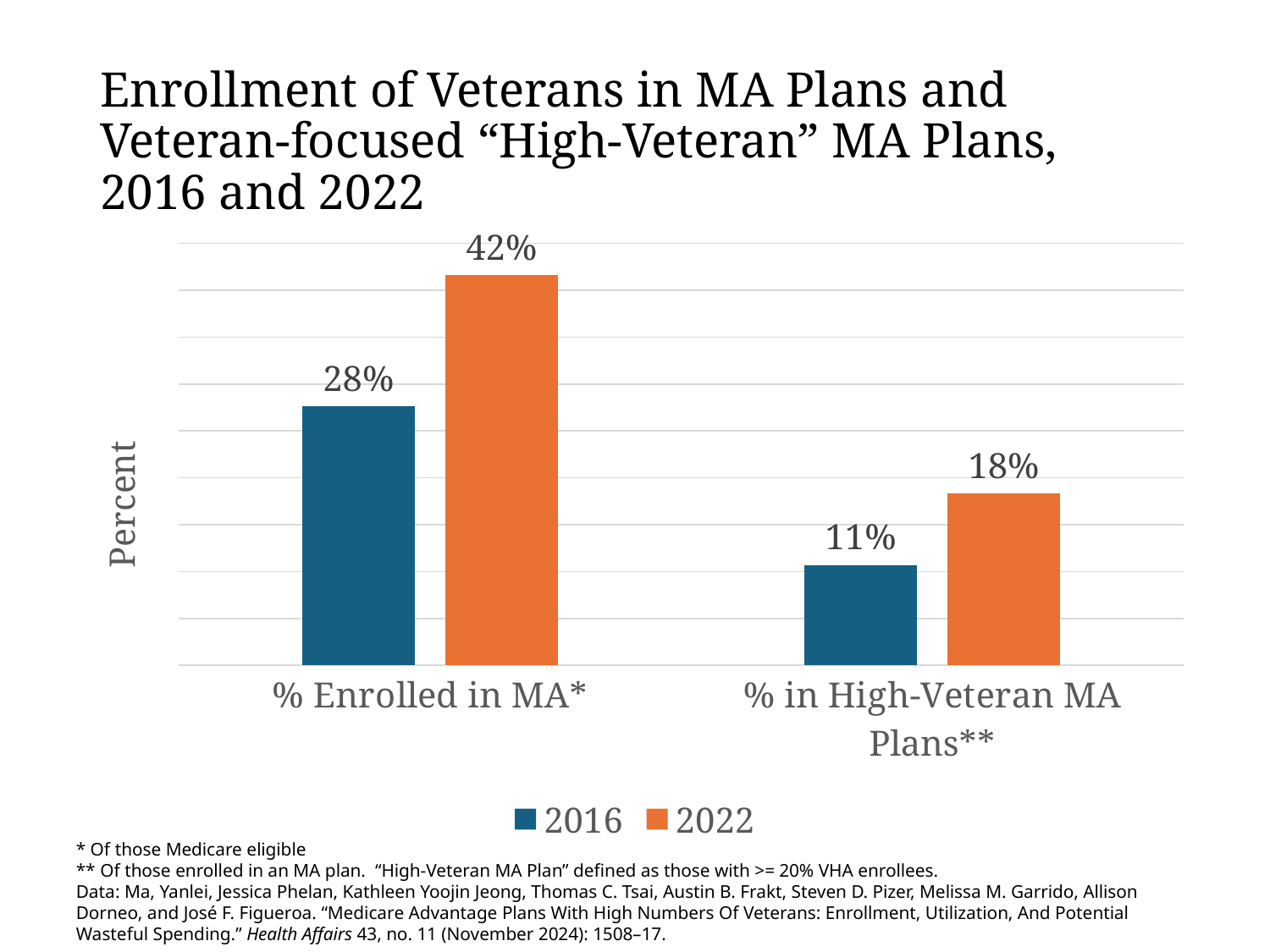
How many series does the legend list? 2 What is the value for 2016 in the "% in High-Veteran MA Plans**" category? 11% What is the value for 2022 in the "% in High-Veteran MA Plans**" category? 18% What kind of chart is shown on the slide? Bar chart Which is larger: the 2016 value for "% Enrolled in MA*" or the 2022 value for "% in High-Veteran MA Plans**"? 2016 value for % Enrolled in MA* What is the difference between the 2022 and 2016 values for "% Enrolled in MA*"? 14% How many categories are shown on the x axis? 2 What is the difference between the 2022 and 2016 values for "% in High-Veteran MA Plans**"? 7% What is the value for 2022 in the "% Enrolled in MA*" category? 42% What is the value for 2016 in the "% Enrolled in MA*" category? 28% Which bar has the lowest value on the chart? 2016, % in High-Veteran MA Plans** Which bar has the highest value on the chart? 2022, % Enrolled in MA*